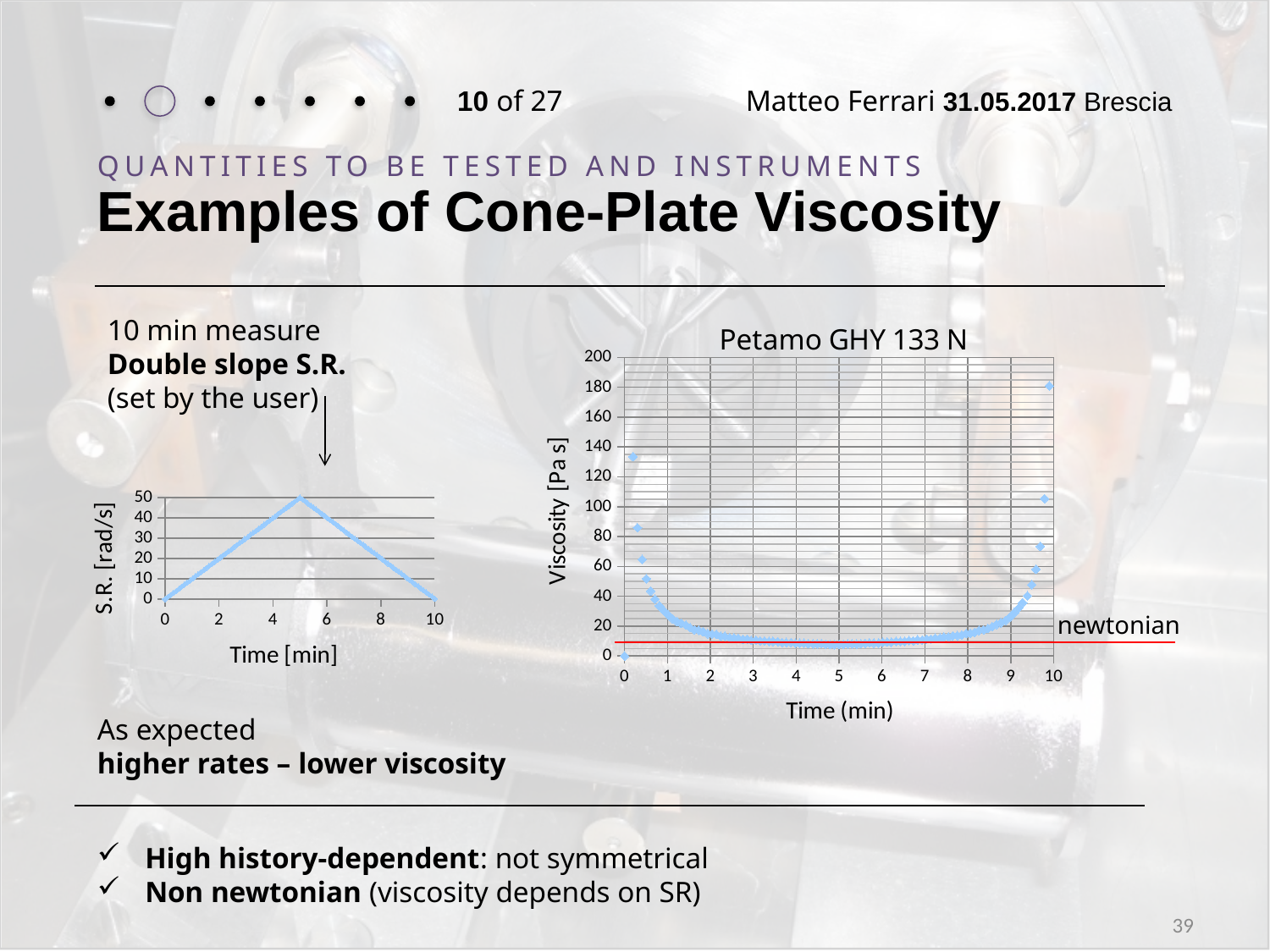
What is the title of the chart on the right of the slide? Petamo GHY 133 N In the Petamo GHY 133 N chart, what label is given to the red horizontal line? newtonian In the Petamo GHY 133 N chart, is the viscosity at 5 min greater or less than 40? less In the Petamo GHY 133 N chart, which is larger: the viscosity at 0 min or at 10 min? 10 min In the S.R. [rad/s] chart on the left, what is the highest S.R. value reached? 50 In the S.R. [rad/s] chart on the left, what is the S.R. value at 10 min? 0 What kind of chart is the Petamo GHY 133 N chart on the right? scatter chart In the S.R. [rad/s] chart on the left, does the S.R. rise or fall between 0 and 5 min? rise In the Petamo GHY 133 N chart, is the viscosity at 0 min greater or less than 120? less In the Petamo GHY 133 N chart, does the viscosity rise or fall between 0 and 5 min? fall In the Petamo GHY 133 N chart, is the viscosity at 10 min greater or less than 160? greater